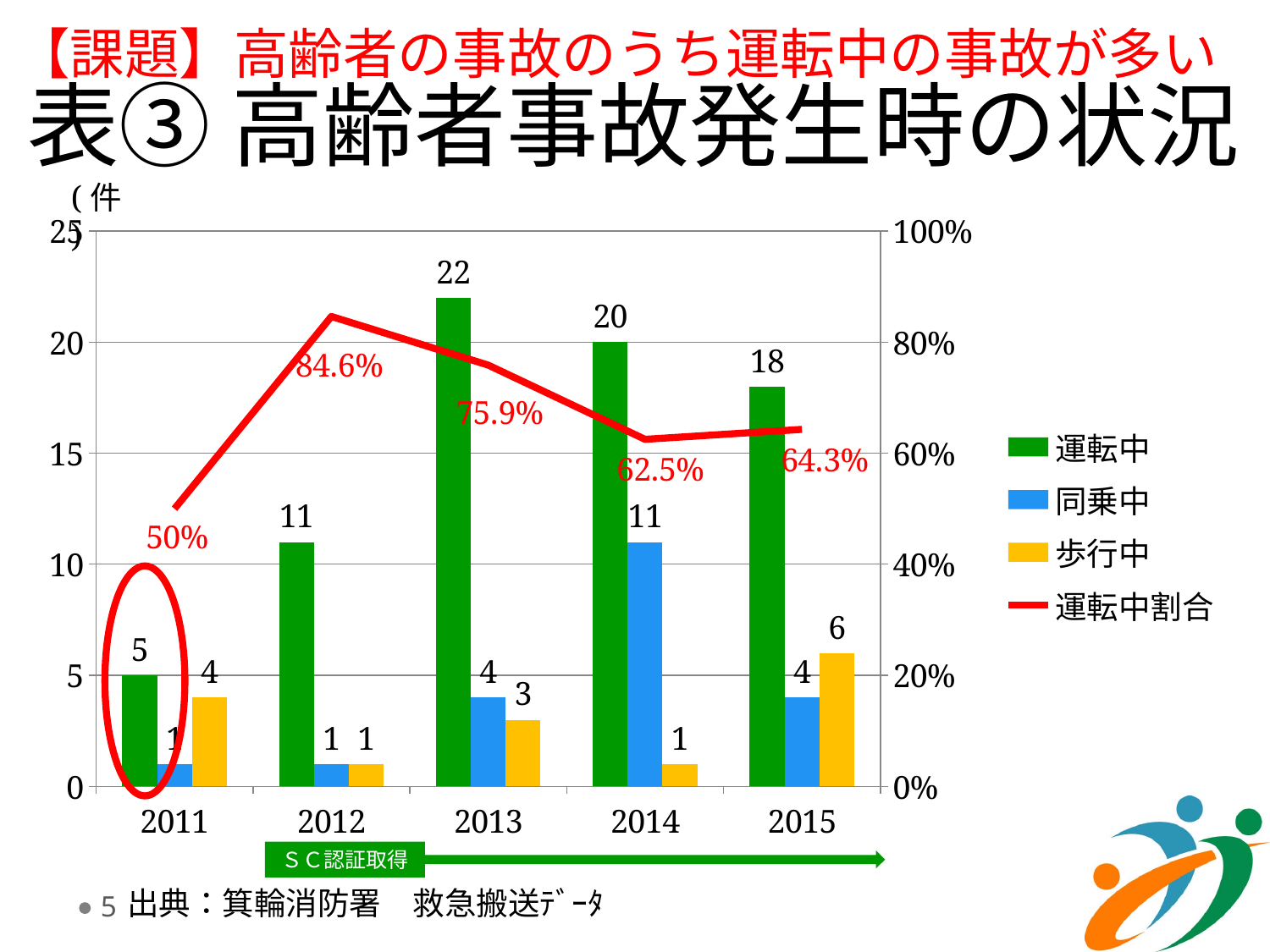
In which year is the 運転中 value highest? 2013 What is the 運転中割合 value for 2012? 84.6% What is the value for 同乗中 in 2014? 11 What is the value for 運転中 in 2013? 22 What is the value for 歩行中 in 2015? 6 In which year is the 運転中 value lowest? 2011 Does the 運転中割合 line rise or fall from 2012 to 2014? fall How many series does the legend list? 4 Which is larger in 2015: 同乗中 or 歩行中? 歩行中 What colour are the 運転中 bars? green What is the difference between the 運転中 values for 2013 and 2011? 17 How many years are shown on the x axis? 5